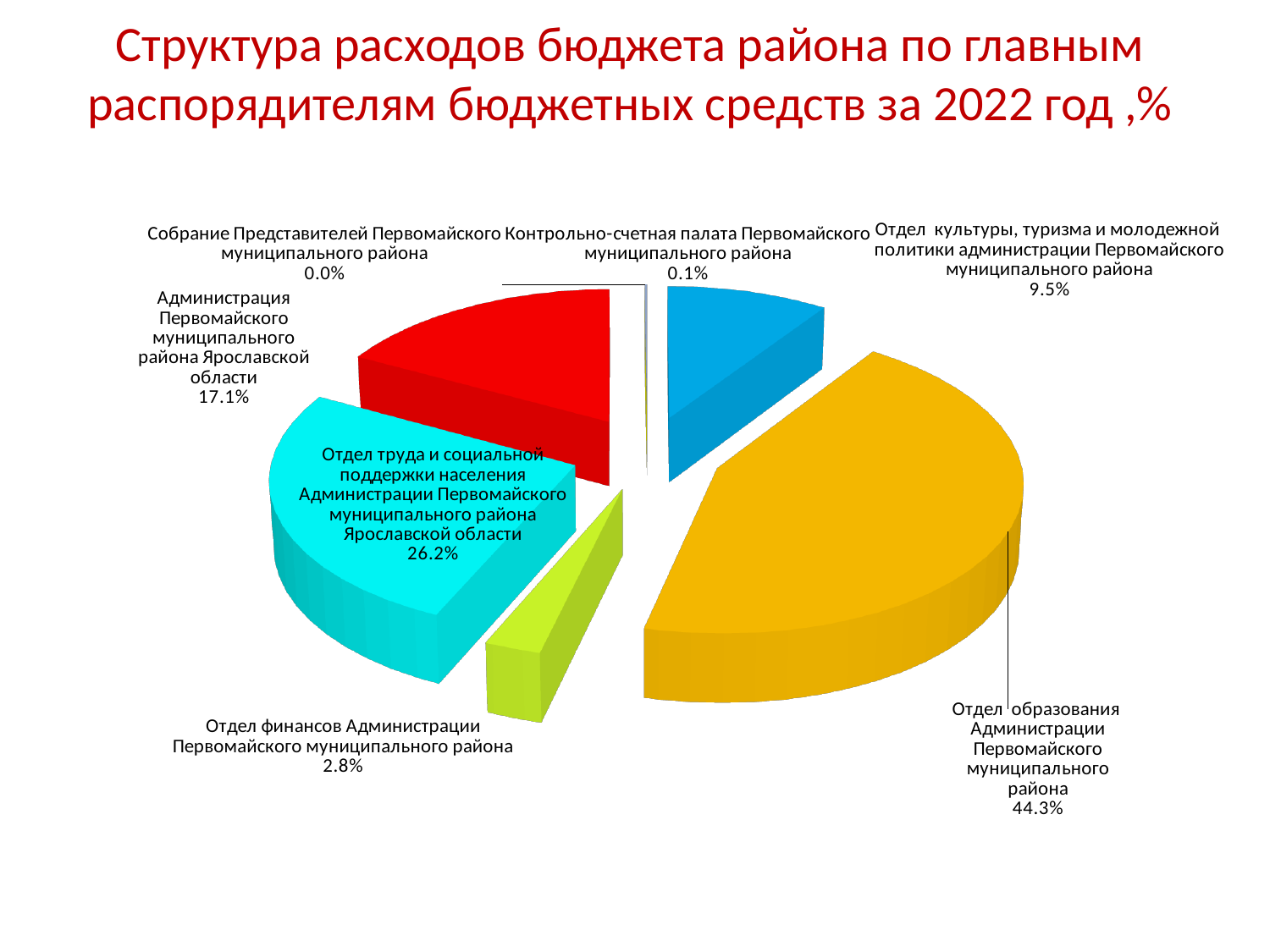
Which budget administrator has the largest share of expenditure? Отдел образования Администрации Первомайского муниципального района Which budget administrator has the smallest share of expenditure? Собрание Представителей Первомайского муниципального района What percentage is shown for Администрация Первомайского муниципального района Ярославской области? 17.1% What type of chart is shown on the slide? Pie chart What percentage is shown for Отдел труда и социальной поддержки населения Администрации Первомайского муниципального района Ярославской области? 26.2% How many slices (budget administrators) does the pie chart show? 7 How many percentage points larger is the share of Отдел образования than the share of Отдел труда и социальной поддержки населения? 18.1 What colour is the slice for Отдел образования Администрации Первомайского муниципального района? Yellow/orange What percentage is shown for Отдел финансов Администрации Первомайского муниципального района? 2.8% What percentage is shown for Контрольно-счетная палата Первомайского муниципального района? 0.1% What share of the district budget expenditure goes to Отдел образования Администрации Первомайского муниципального района? 44.3% Which has a larger share: Администрация Первомайского муниципального района Ярославской области or Отдел культуры, туризма и молодежной политики? Администрация Первомайского муниципального района Ярославской области